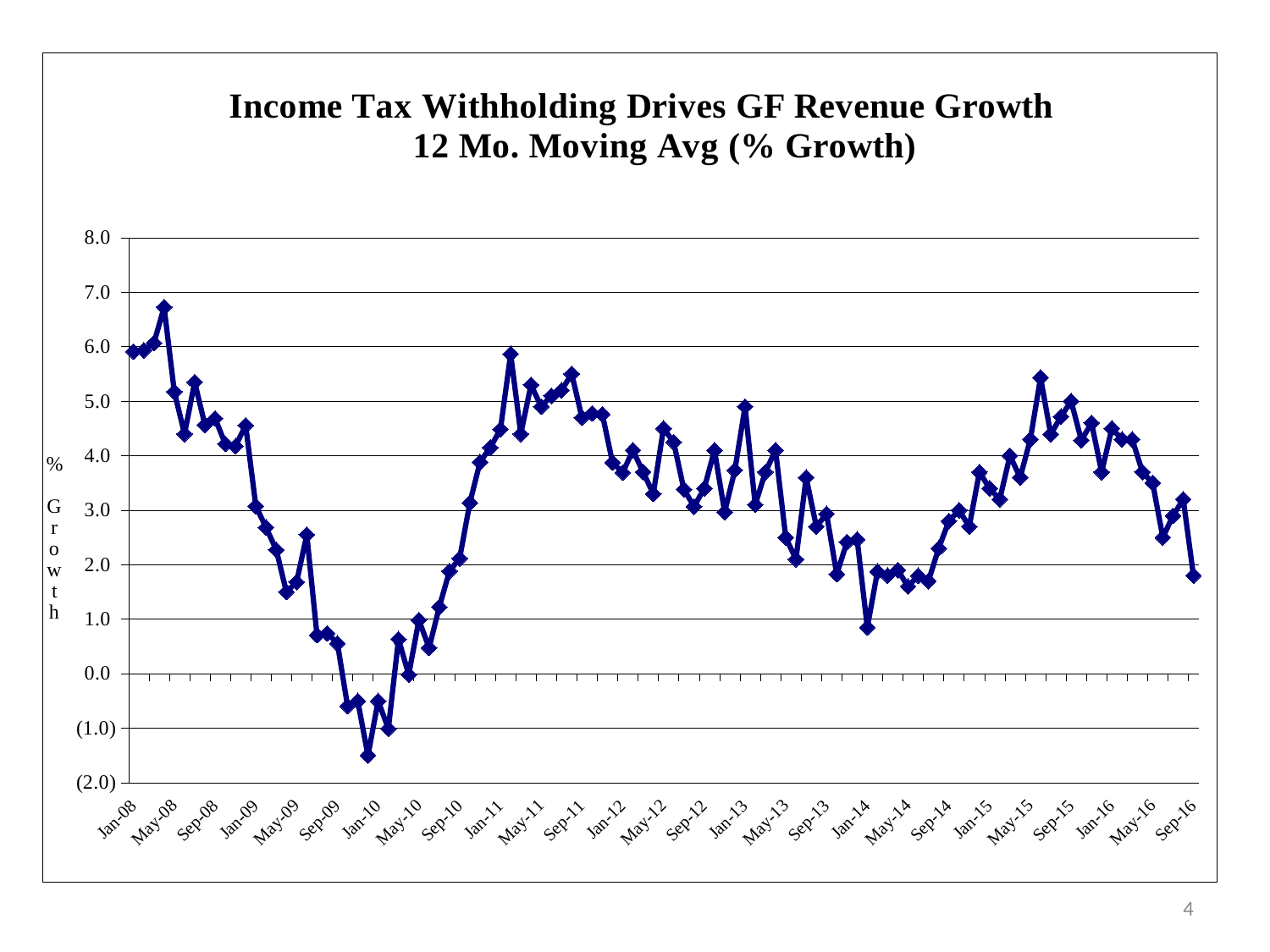
Which has the larger value, Jan-08 or Jan-14? Jan-08 What kind of chart is shown on the slide? line chart What is the title of the chart? Income Tax Withholding Drives GF Revenue Growth 12 Mo. Moving Avg (% Growth) Is the value for Jan-08 greater or less than 5.0? greater Is the value for Jan-14 greater or less than 2.0? less Is the value for Sep-16 greater or less than 3.0? less What is the label on the vertical axis of the chart? % Growth How many lines are plotted on the chart? 1 Do the values rise or fall between Jan-08 and Jan-10? fall How many date labels are shown along the x axis? 27